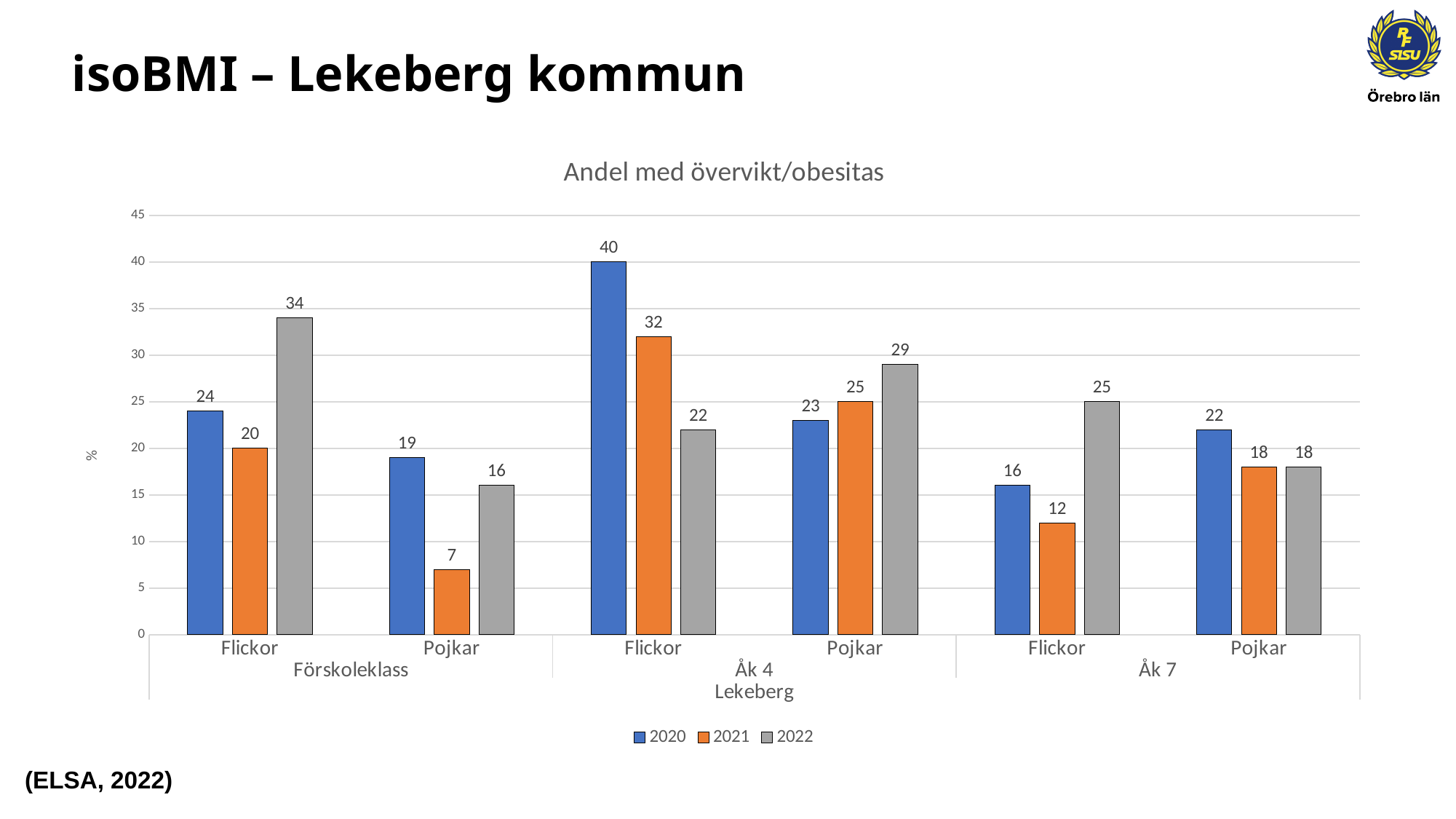
Which group and year has the lowest value in the chart? Pojkar, Förskoleklass, 2021 What is the value for Pojkar in Förskoleklass for 2021? 7 Is the value for Flickor in Förskoleklass in 2020 greater or less than 20? greater What is the title of the chart? Andel med övervikt/obesitas How many series does the legend list? 3 What kind of chart is shown on the slide? Bar chart What is the value for Flickor in Förskoleklass for 2022? 34 What is the value for Flickor in Åk 4 for 2020? 40 Which is larger for Pojkar in Åk 4: the 2021 value or the 2022 value? 2022 What is the value for Flickor in Åk 7 for 2021? 12 What is the difference between the 2020 and 2022 values for Flickor in Åk 4? 18 Which group and year has the highest value in the chart? Flickor, Åk 4, 2020